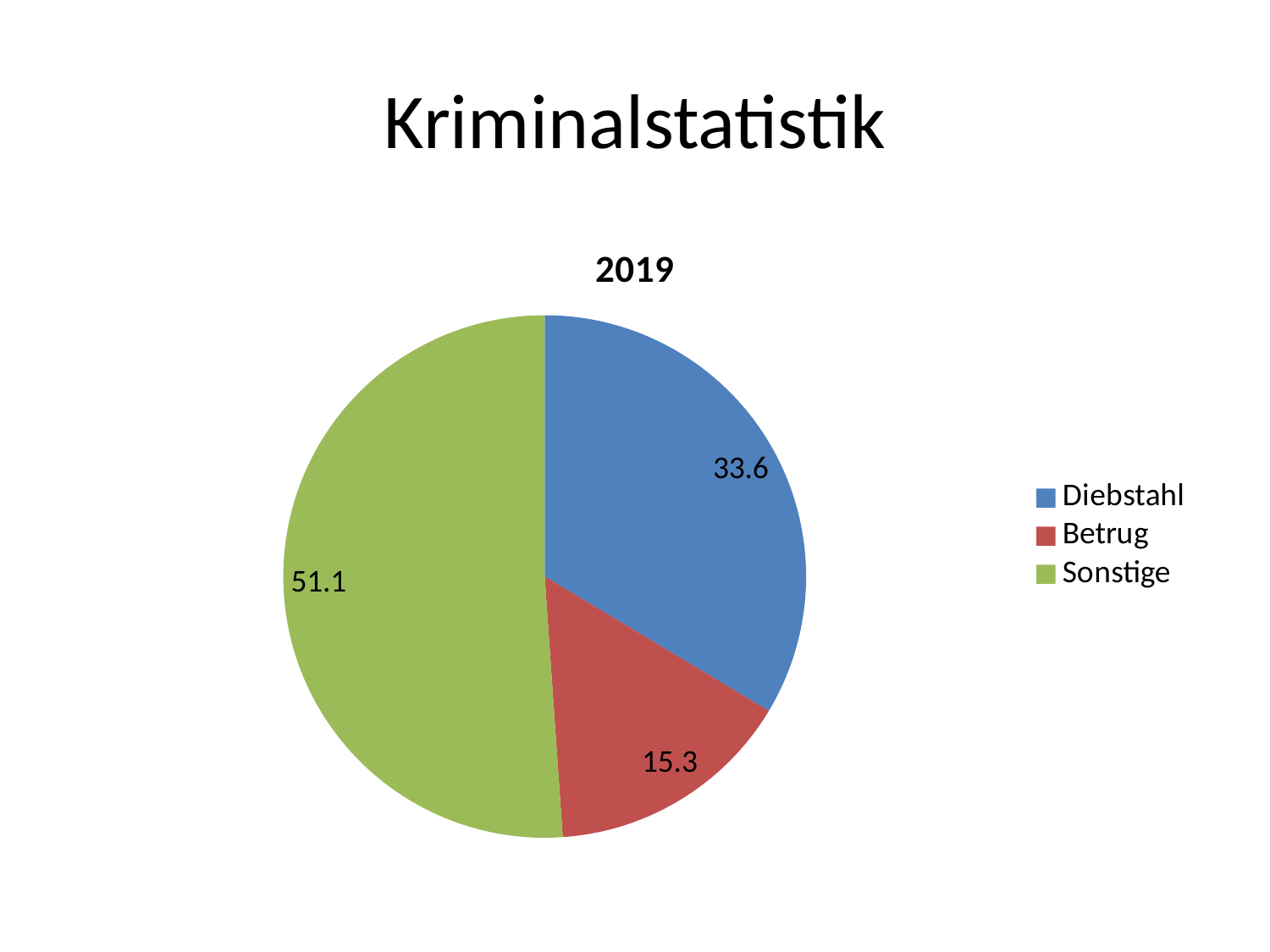
What is the difference between the values for Sonstige and Diebstahl? 17.5 What is the value for Diebstahl in the pie chart? 33.6 What kind of chart is shown on the slide? Pie chart Which category has the largest slice in the pie chart? Sonstige What is the value for Sonstige in the pie chart? 51.1 What is the title of the chart? 2019 Which category has the smallest slice in the pie chart? Betrug How many categories does the pie chart show? 3 Which colour represents Betrug in the pie chart? Red What is the difference between the values for Diebstahl and Betrug? 18.3 What is the value for Betrug in the pie chart? 15.3 Which is larger, the value for Diebstahl or the value for Betrug? Diebstahl